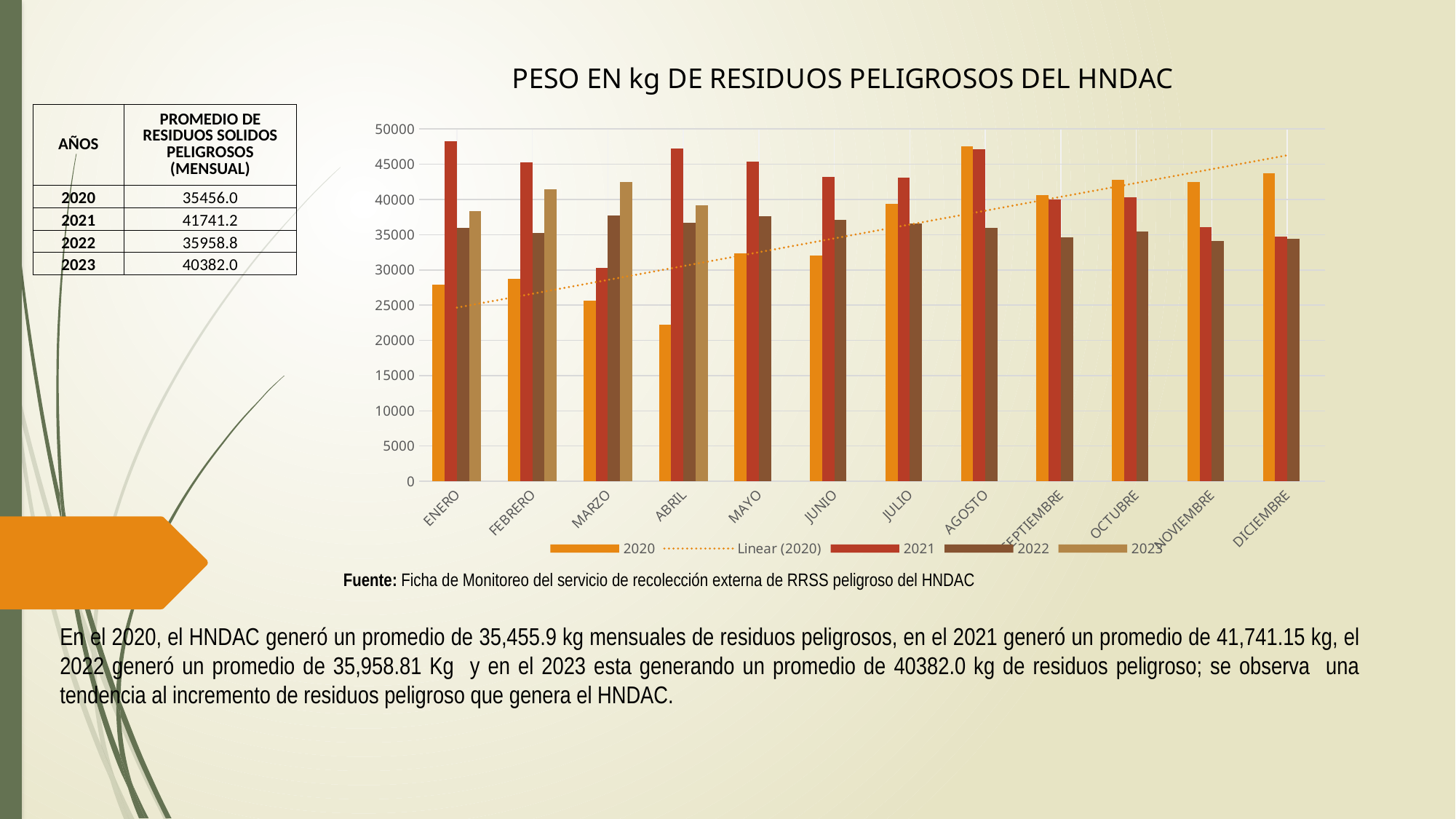
What is the title of the chart? PESO EN kg DE RESIDUOS PELIGROSOS DEL HNDAC Is the 2020 value for ABRIL greater or less than 25000? less In which month is the 2021 value the lowest? MARZO Is the 2023 value for MARZO greater or less than 40000? greater How many entries does the chart legend list? 5 For DICIEMBRE, which is larger: the 2020 value or the 2021 value? 2020 What kind of chart is shown on the slide? bar chart How many months (categories) are shown on the x axis of the chart? 12 Is the 2021 value for ENERO greater or less than 45000? greater In which month is the 2020 value the lowest? ABRIL Which series has a dotted linear trend line in the chart? 2020 In which month is the 2020 value the highest? AGOSTO